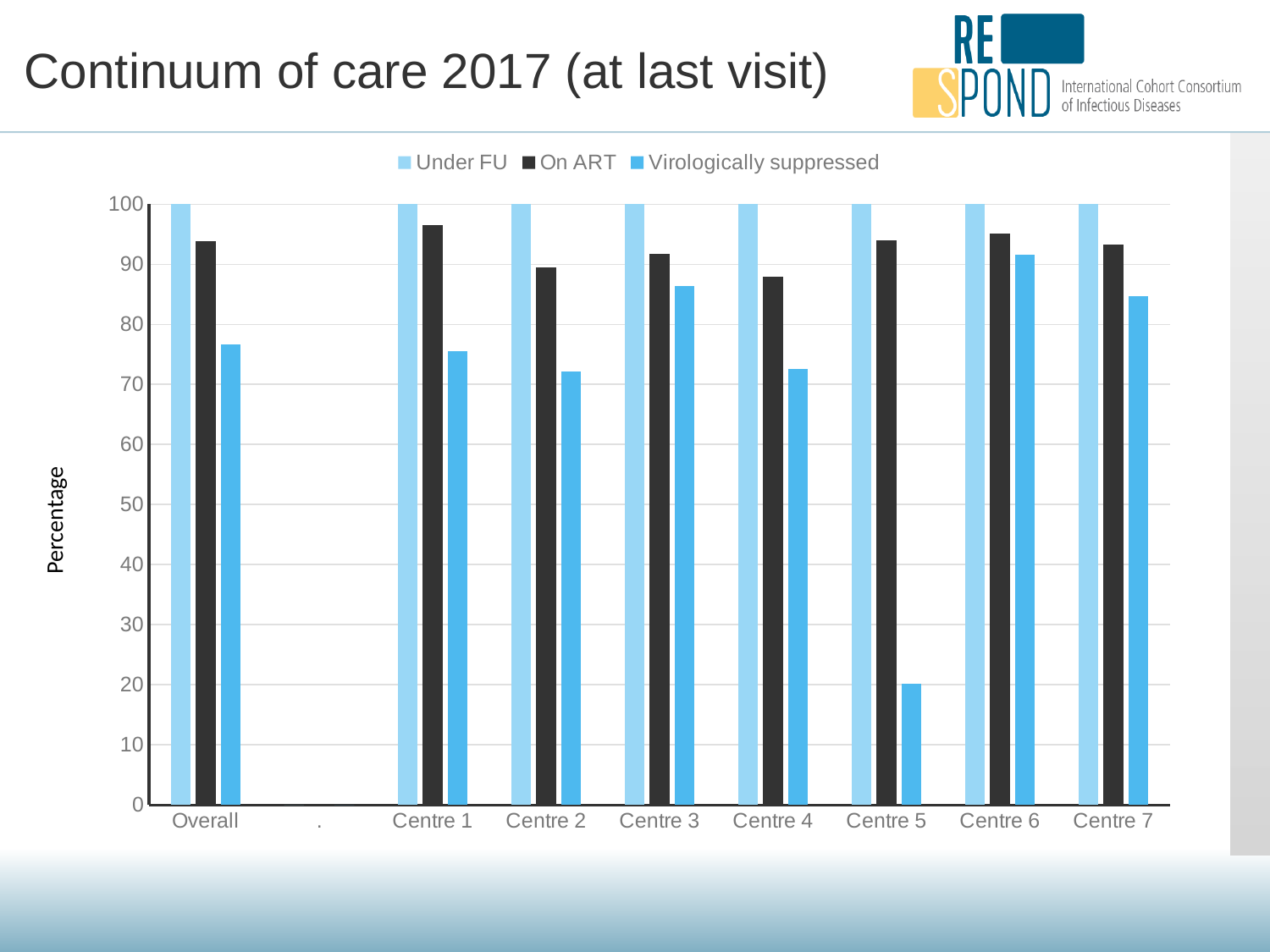
What kind of chart is shown on the slide? Bar chart Is the Virologically suppressed value for Centre 3 greater or less than 80? greater What is the Under FU value for Overall? 100 Which is larger, the On ART value for Centre 1 or for Centre 4? Centre 1 Which is larger, the Virologically suppressed value for Centre 3 or for Centre 4? Centre 3 Which category has the lowest Virologically suppressed value? Centre 5 Is the Virologically suppressed value for Centre 5 greater or less than 30? less What is the label on the y axis? Percentage How many series does the legend list? 3 Is the On ART value for Centre 4 greater or less than 90? less How many centres (Centre 1 to Centre 7) are shown on the x axis? 7 Which centre has the highest Virologically suppressed value? Centre 6